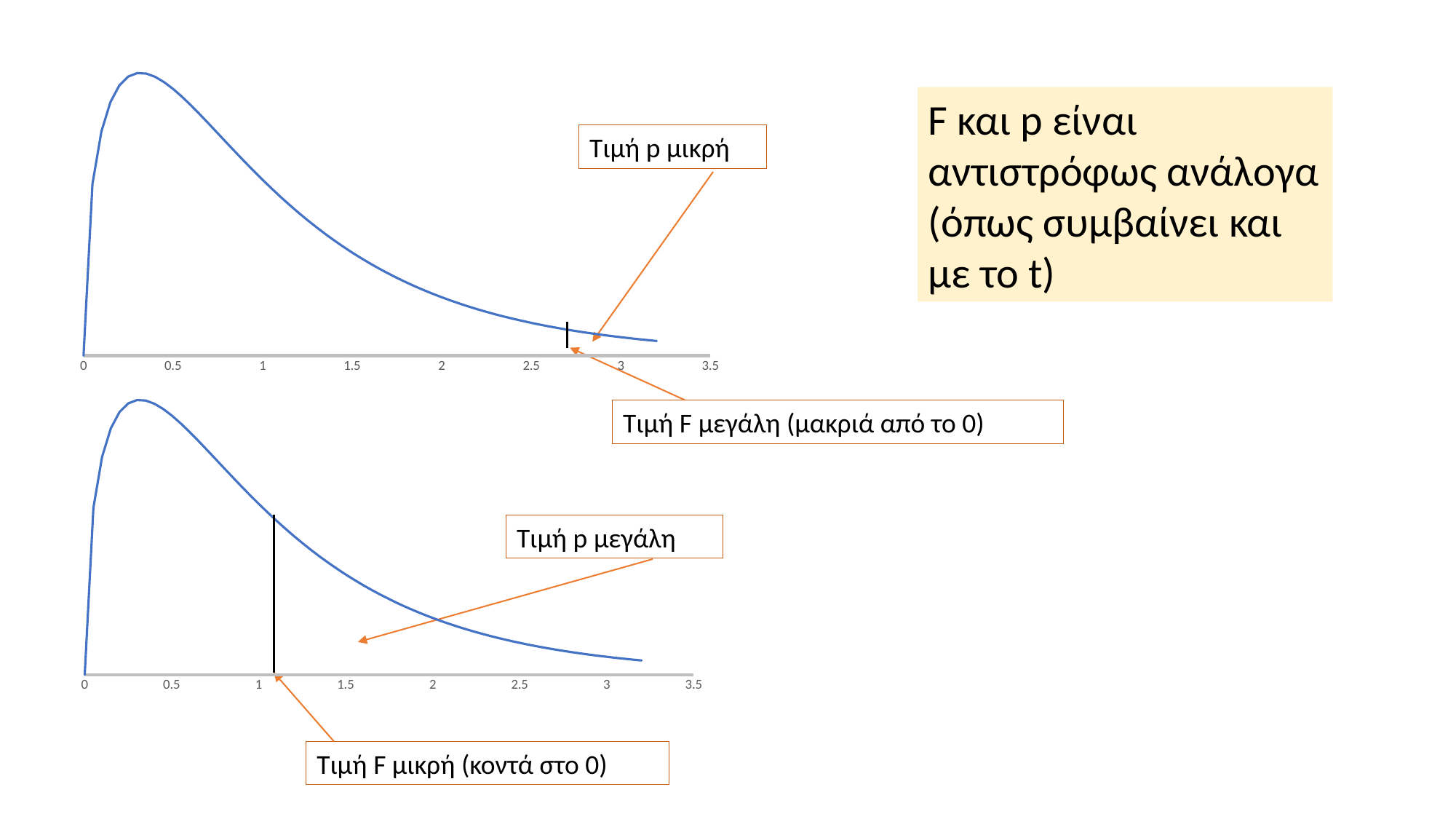
In the bottom chart, is the x position of the black vertical marker line greater or less than 0.5? greater In the top chart, what is the largest value shown on the x axis? 3.5 What kind of chart is the bottom chart on the slide? line chart In the top chart, is the x position of the black vertical marker line greater or less than 3? less In the bottom chart, is the x position of the black vertical marker line greater or less than 1.5? less How many charts are shown on the slide? 2 Which chart has its black vertical marker line farther from 0 on the x axis, the top chart or the bottom chart? the top chart What colour is the curve plotted in both charts? blue In the bottom chart, does the curve rise or fall along the x axis between 1 and 3? fall In the top chart, does the curve rise or fall along the x axis after its peak near 0.3? fall What kind of chart is the top chart on the slide? line chart